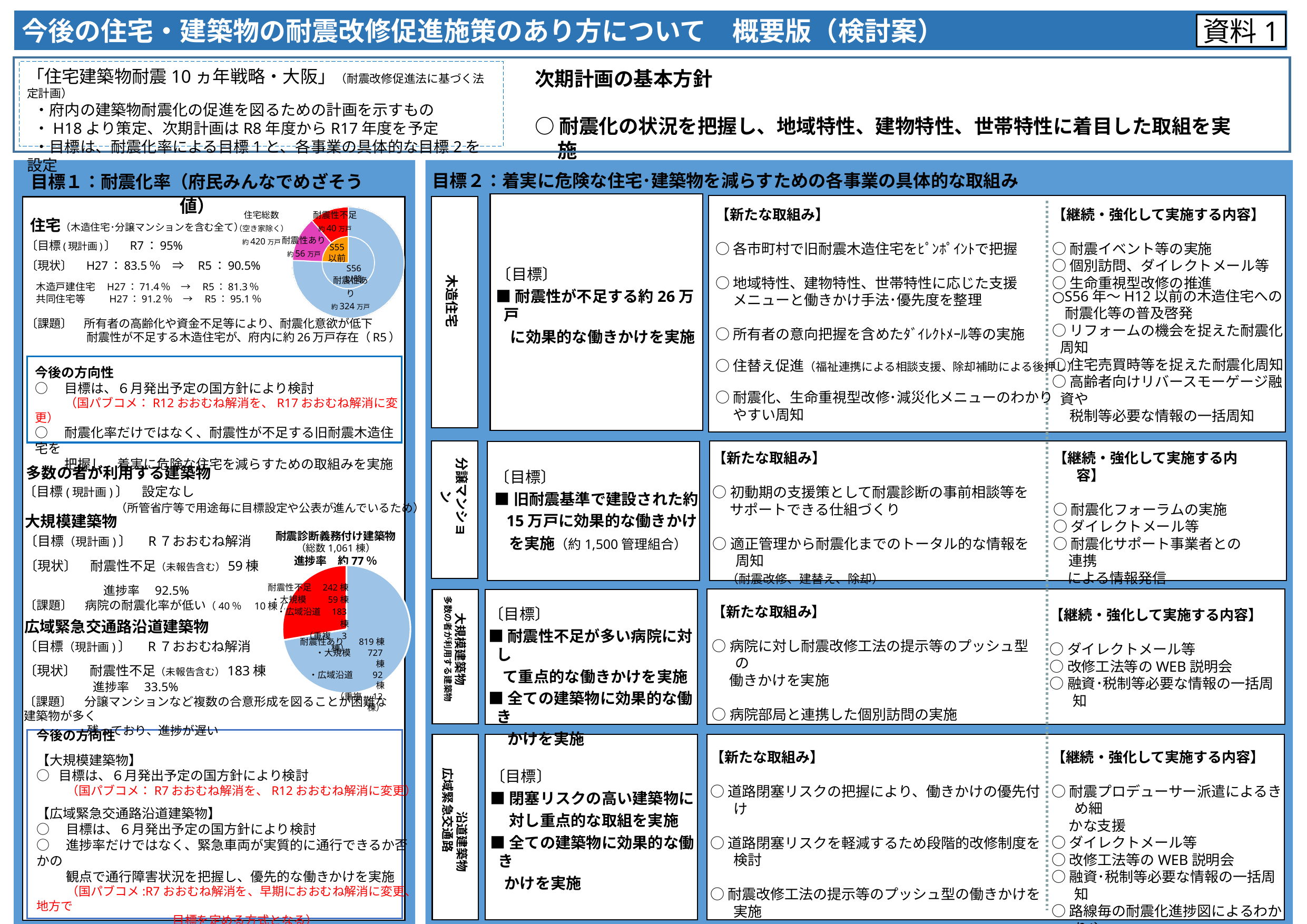
In the 住宅総数 doughnut chart, which segment is the largest? S56以降 耐震性あり (約324万戸) In the 耐震診断義務付け建築物 pie chart, how many 大規模 buildings are listed under 耐震性あり? 727棟 What 進捗率 is printed above the 耐震診断義務付け建築物 pie chart? 約77％ In the 耐震診断義務付け建築物 pie chart, what is the difference between the 耐震性あり and 耐震性不足 counts? 577棟 What kind of chart is the 耐震診断義務付け建築物 chart at the bottom left of the slide? pie chart In the 住宅総数 doughnut chart at the top left, what is the total number of dwellings (住宅総数)? 約420万戸 How many slices does the 耐震診断義務付け建築物 pie chart have? 2 In the 耐震診断義務付け建築物 pie chart, how many buildings are labelled 耐震性あり? 819棟 In the 耐震診断義務付け建築物 pie chart, which slice is larger, 耐震性不足 or 耐震性あり? 耐震性あり In the 耐震診断義務付け建築物 pie chart, how many buildings are labelled 耐震性不足? 242棟 What is the total number of buildings (総数) shown for the 耐震診断義務付け建築物 pie chart? 1,061棟 In the 住宅総数 doughnut chart, how many dwellings are labelled 耐震性不足? 約40万戸